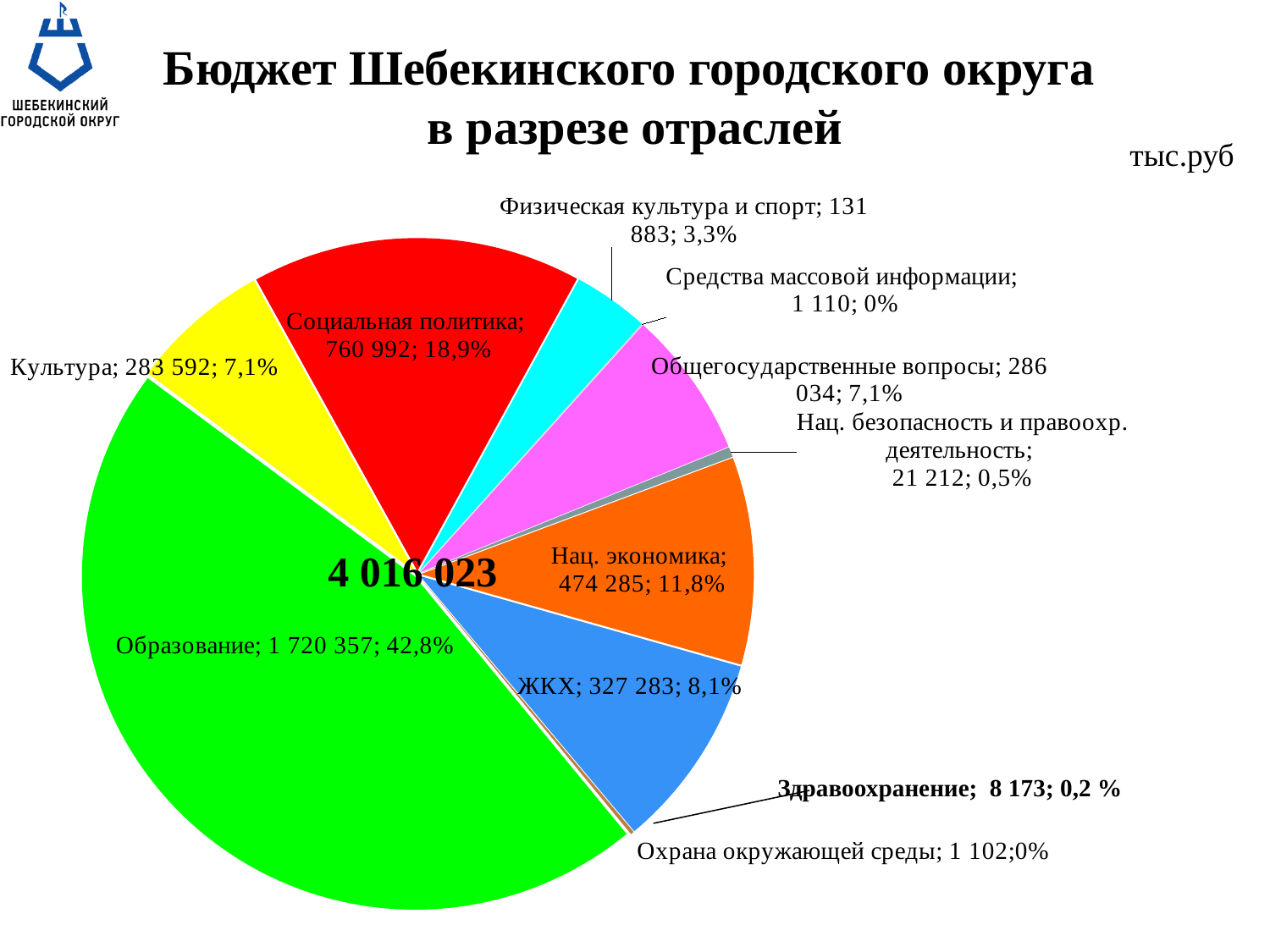
What is the value for Нац. экономика? 474 285 In what units are the values on the chart given? тыс.руб What is the value for Образование? 1 720 357 What is the difference between the values for Образование and Социальная политика? 959 365 Which is larger, Нац. экономика or ЖКХ? Нац. экономика What share of the pie does ЖКХ take? 8,1% What kind of chart is shown on the slide? Pie chart How many categories are shown in the pie chart? 11 What total value is printed in the centre of the pie chart? 4 016 023 Which category has the largest slice of the pie? Образование What is the value for Нац. безопасность и правоохр. деятельность? 21 212 What share of the pie does Социальная политика take? 18,9%